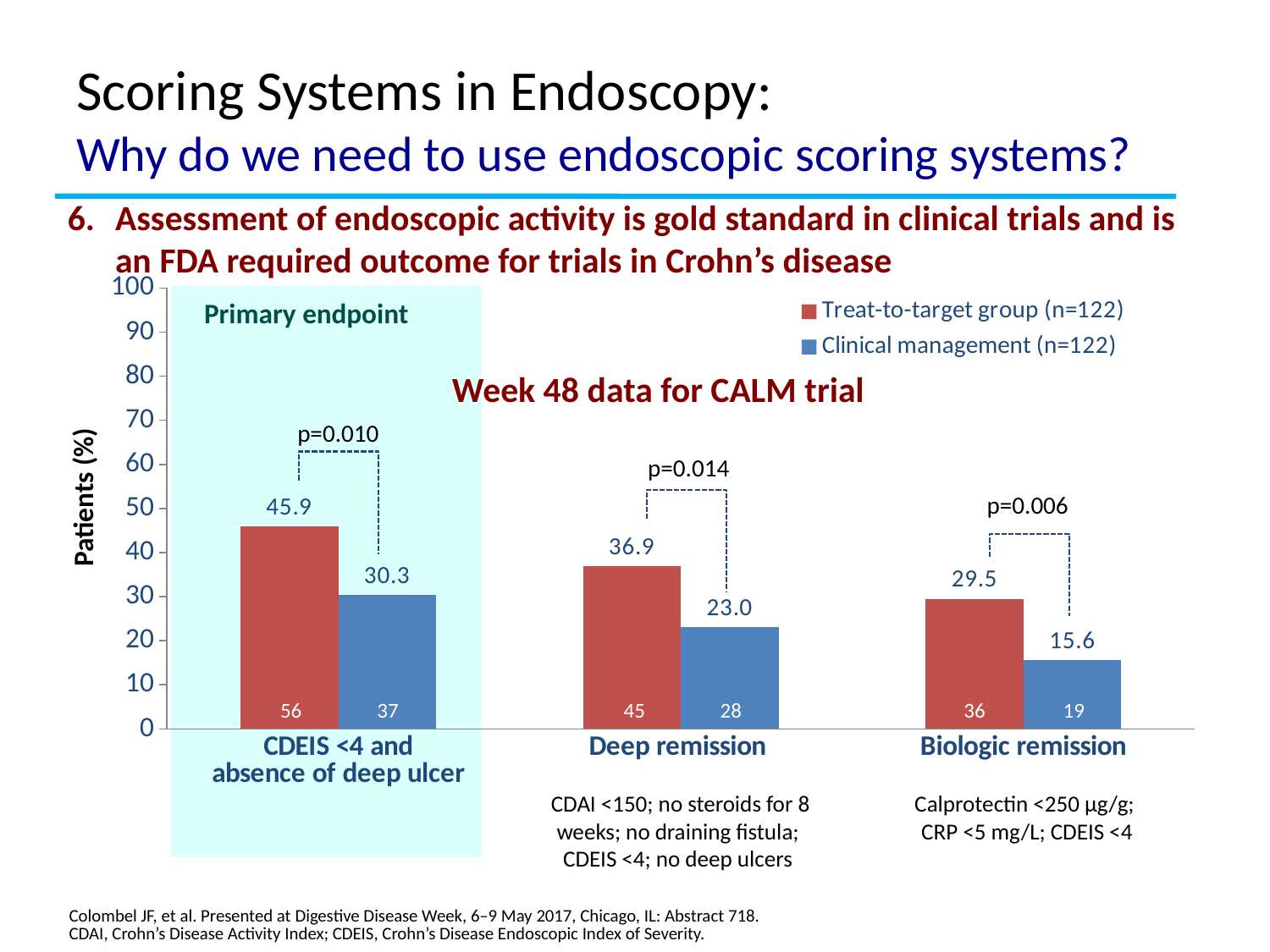
What is the label of the y axis of the chart? Patients (%) What is the value for the Clinical management group in the Biologic remission category? 15.6 What percentage of patients in the Treat-to-target group achieved CDEIS <4 and absence of deep ulcer? 45.9 How many categories are shown on the x axis of the chart? 3 What percentage of patients in the Clinical management group achieved Deep remission? 23.0 Which category has the highest value for the Treat-to-target group? CDEIS <4 and absence of deep ulcer In the Biologic remission category, which group has the larger value: Treat-to-target or Clinical management? Treat-to-target group What is the difference between the Treat-to-target group and the Clinical management group in the Deep remission category? 13.9 What p-value is shown for the Deep remission comparison? p=0.014 How many series does the legend list? 2 Which category has the lowest value for the Clinical management group? Biologic remission What kind of chart is shown on the slide? Bar chart